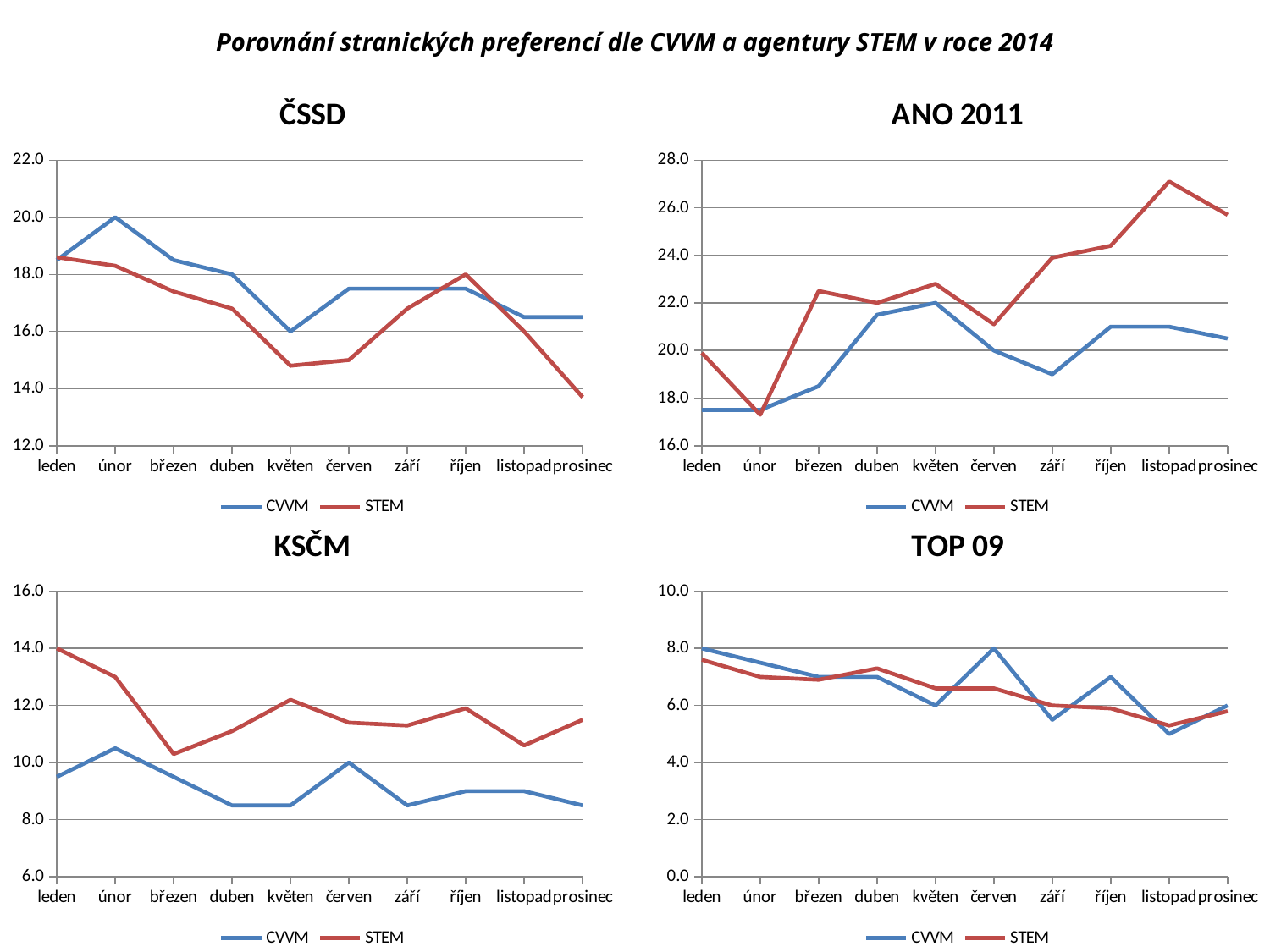
In the ČSSD chart, what is the CVVM value for únor? 20.0 In the ANO 2011 chart, is the STEM value for listopad greater or less than 26.0? greater In the ČSSD chart, what is the difference between the CVVM values for únor and květen? 4.0 How many months are plotted along the x axis of the KSČM chart? 10 In the KSČM chart, which series has the larger value in leden, CVVM or STEM? STEM What kind of chart is the ČSSD chart? line chart In the ČSSD chart, in which month is the STEM value lowest? prosinec How many series does the legend of the ANO 2011 chart list? 2 In the ANO 2011 chart, what is the CVVM value for květen? 22.0 In the KSČM chart, does the CVVM line generally rise or fall from leden to prosinec? fall In the ANO 2011 chart, in which month is the STEM value highest? listopad In the TOP 09 chart, what is the CVVM value for leden? 8.0